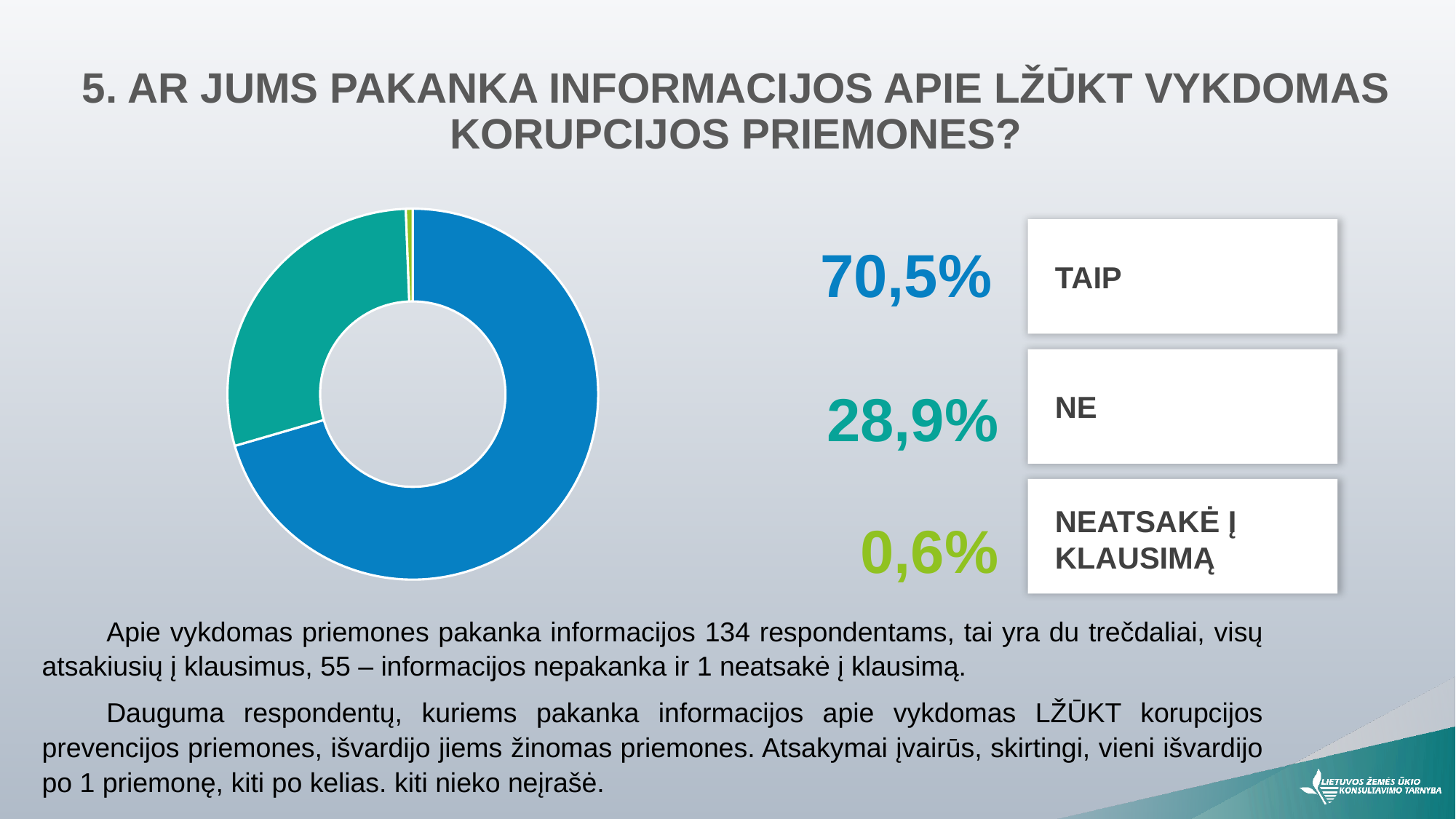
Which answer category has the largest share of the chart? TAIP What is the difference in percentage points between the TAIP and NE shares? 41,6 What colour is the slice representing TAIP? Blue What share of respondents answered NE? 28,9% How many categories are shown in the chart? 3 What kind of chart is shown on the slide? Pie chart (donut) What colour is the slice representing NE? Teal (green-blue) What share of respondents answered TAIP? 70,5% Which answer category has the smallest share of the chart? NEATSAKĖ Į KLAUSIMĄ What is the difference in percentage points between the NE share and the NEATSAKĖ Į KLAUSIMĄ share? 28,3 What share of respondents is shown for NEATSAKĖ Į KLAUSIMĄ? 0,6% Which is larger, the share for TAIP or the share for NE? TAIP